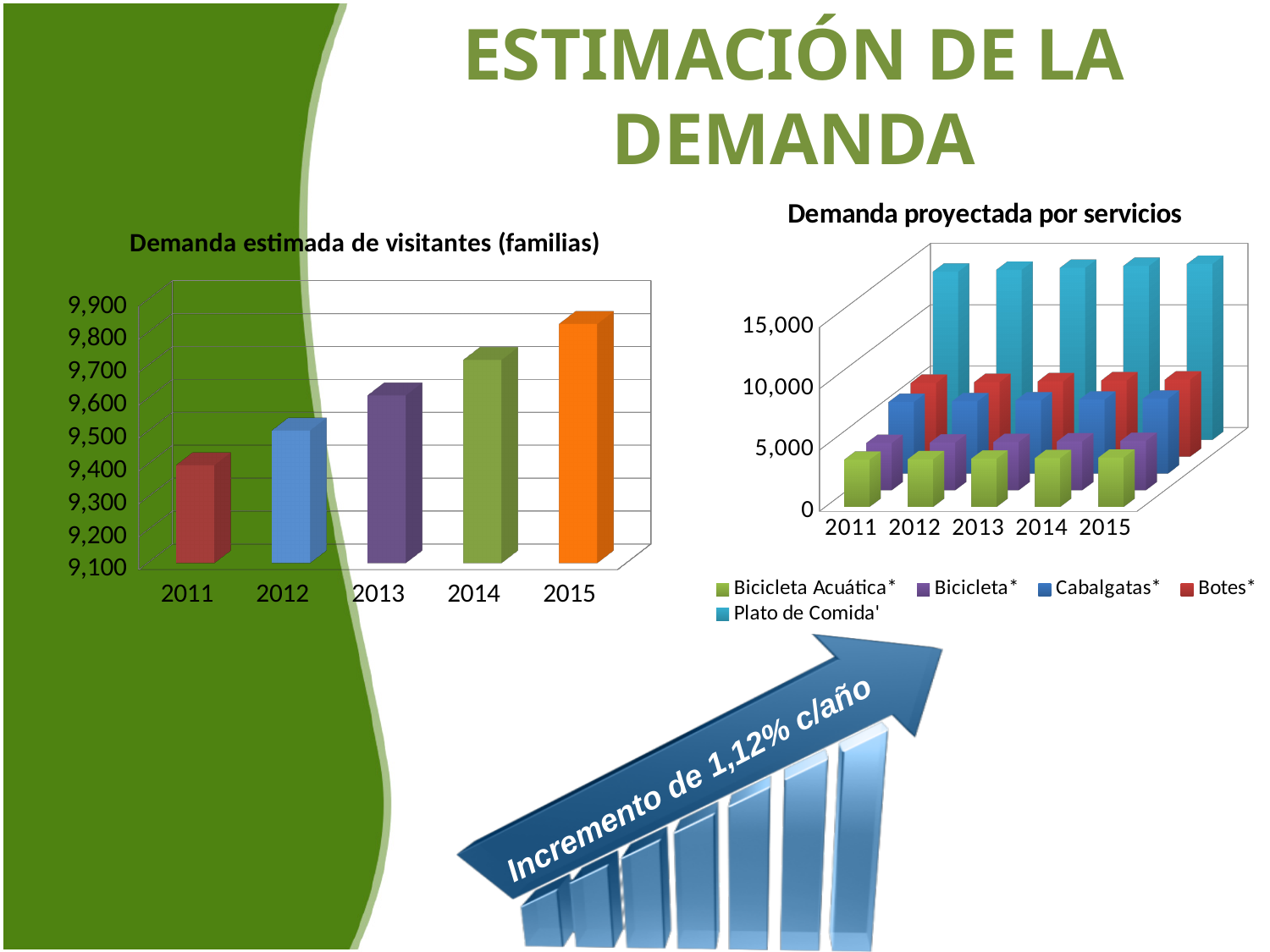
How many years are shown on the x axis of the 'Demanda estimada de visitantes (familias)' chart? 5 In the 'Demanda estimada de visitantes (familias)' chart, is the value for 2011 greater or less than 9,500? less In the 'Demanda proyectada por servicios' chart, which service has the highest demand? Plato de Comida' How many series does the legend of the 'Demanda proyectada por servicios' chart list? 5 In the 'Demanda estimada de visitantes (familias)' chart, which year has the highest value? 2015 In the 'Demanda proyectada por servicios' chart, is the value for Plato de Comida' in 2011 greater or less than 10,000? greater What kind of chart is the 'Demanda estimada de visitantes (familias)' chart? bar chart In the 'Demanda estimada de visitantes (familias)' chart, which year has the lowest value? 2011 In the 'Demanda estimada de visitantes (familias)' chart, is the value for 2015 greater or less than 9,700? greater In the 'Demanda estimada de visitantes (familias)' chart, do the values rise or fall from 2011 to 2015? rise What is the title of the chart on the right side of the slide? Demanda proyectada por servicios In the 'Demanda estimada de visitantes (familias)' chart, which is larger, the value for 2013 or the value for 2012? 2013